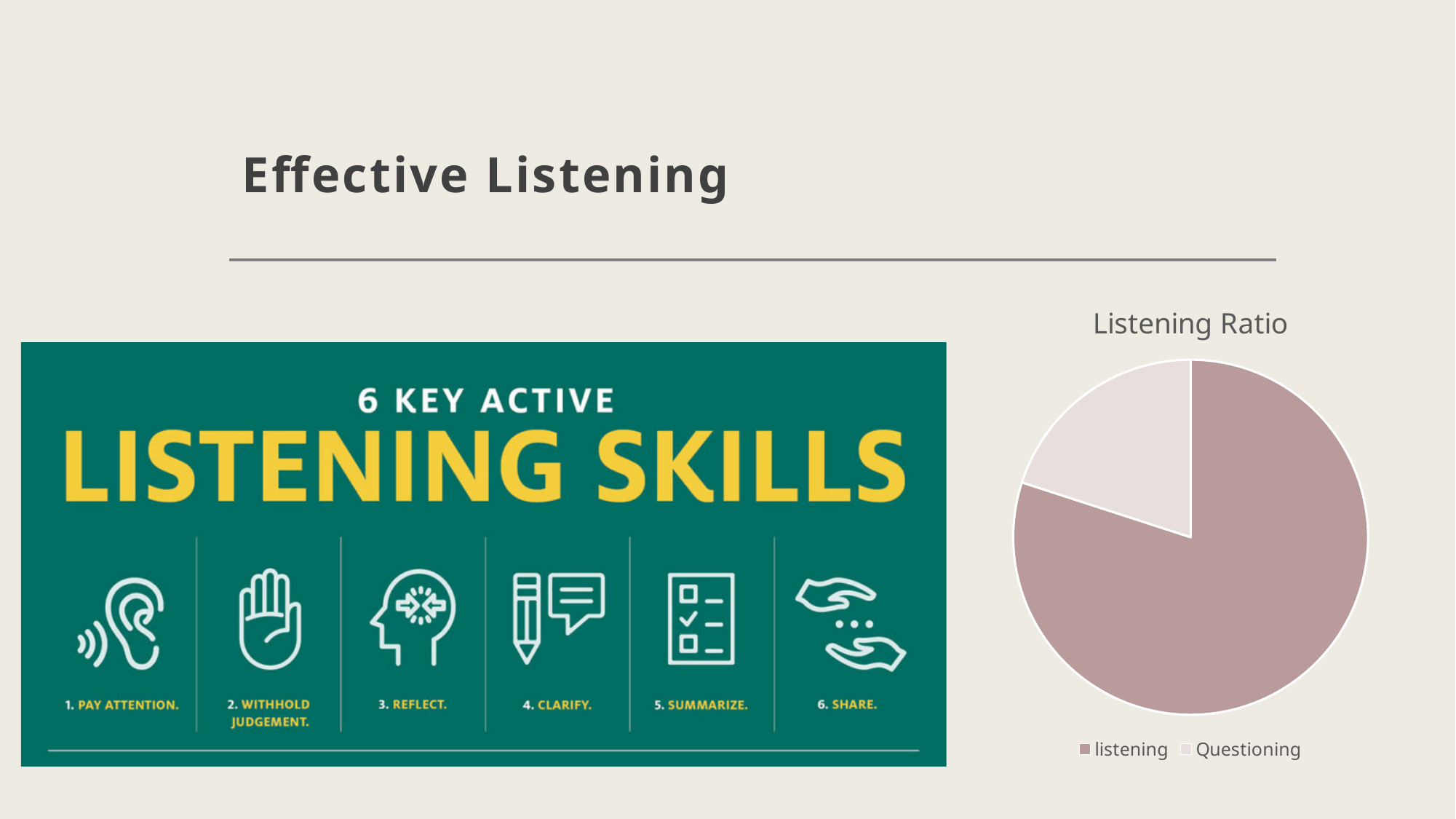
How many entries does the legend of the Listening Ratio pie chart list? 2 Which slice of the Listening Ratio pie chart is the smallest? Questioning What kind of chart is shown under the title "Listening Ratio"? pie chart What is the title of the pie chart on the slide? Listening Ratio How many slices does the Listening Ratio pie chart have? 2 In the Listening Ratio pie chart, which is larger: listening or Questioning? listening What are the two categories shown in the legend of the Listening Ratio pie chart? listening and Questioning Which slice of the Listening Ratio pie chart is the largest? listening